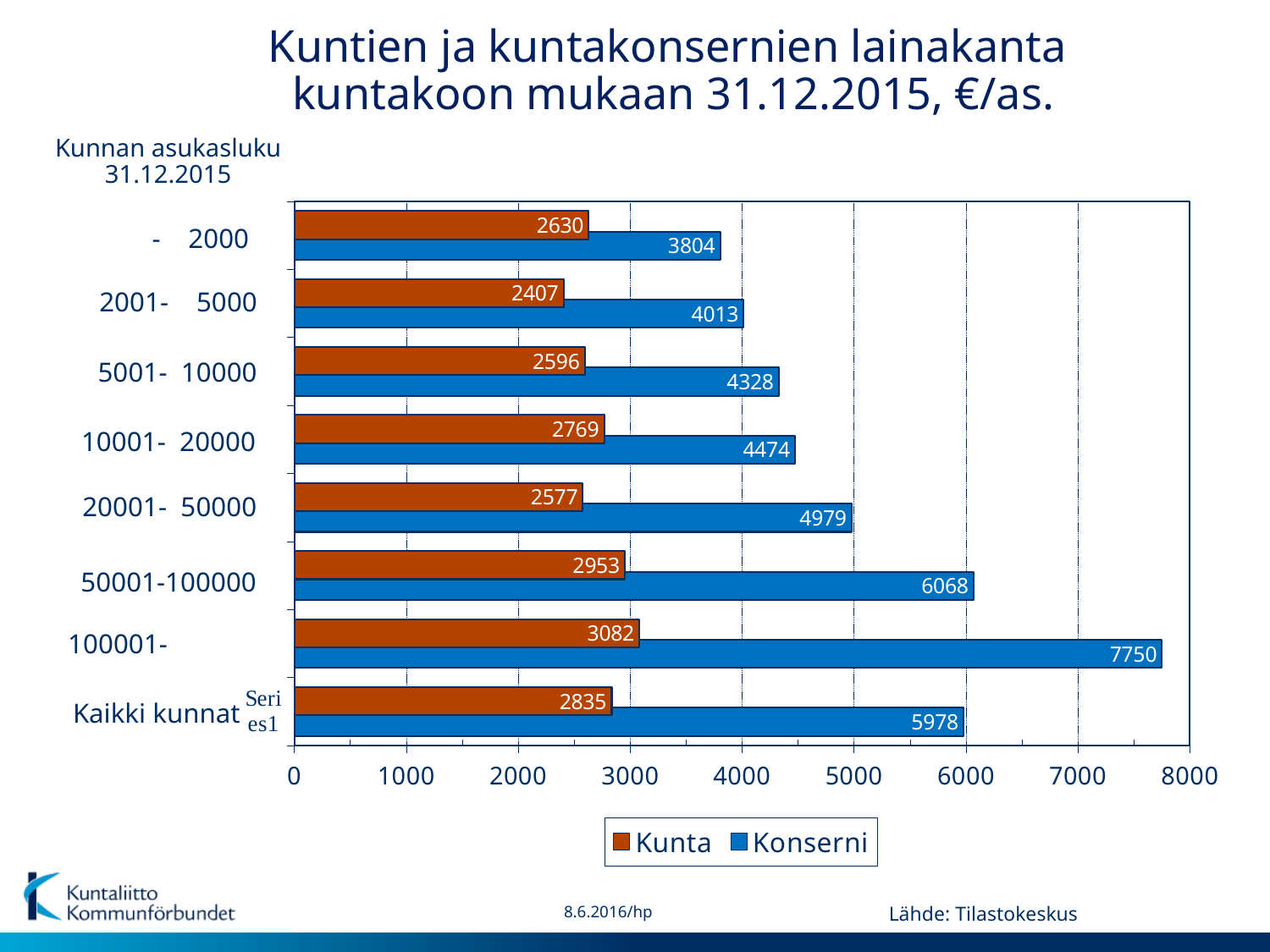
What kind of chart is shown on the slide? bar chart What is the difference between the Konserni and Kunta values for the 50001-100000 category? 3115 What is the Kunta value for the 2001- 5000 category? 2407 What is the Konserni value for the 100001- category? 7750 How many series does the legend list? 2 Which category has the highest Konserni value? 100001- What is the Konserni value for Kaikki kunnat? 5978 Which is larger, the Kunta value for 10001- 20000 or the Kunta value for 20001- 50000? 10001- 20000 How many categories are shown on the chart? 8 Is the Konserni value for the 20001- 50000 category greater or less than 5000? less Which series is shown in blue in the legend? Konserni Which category has the lowest Kunta value? 2001- 5000